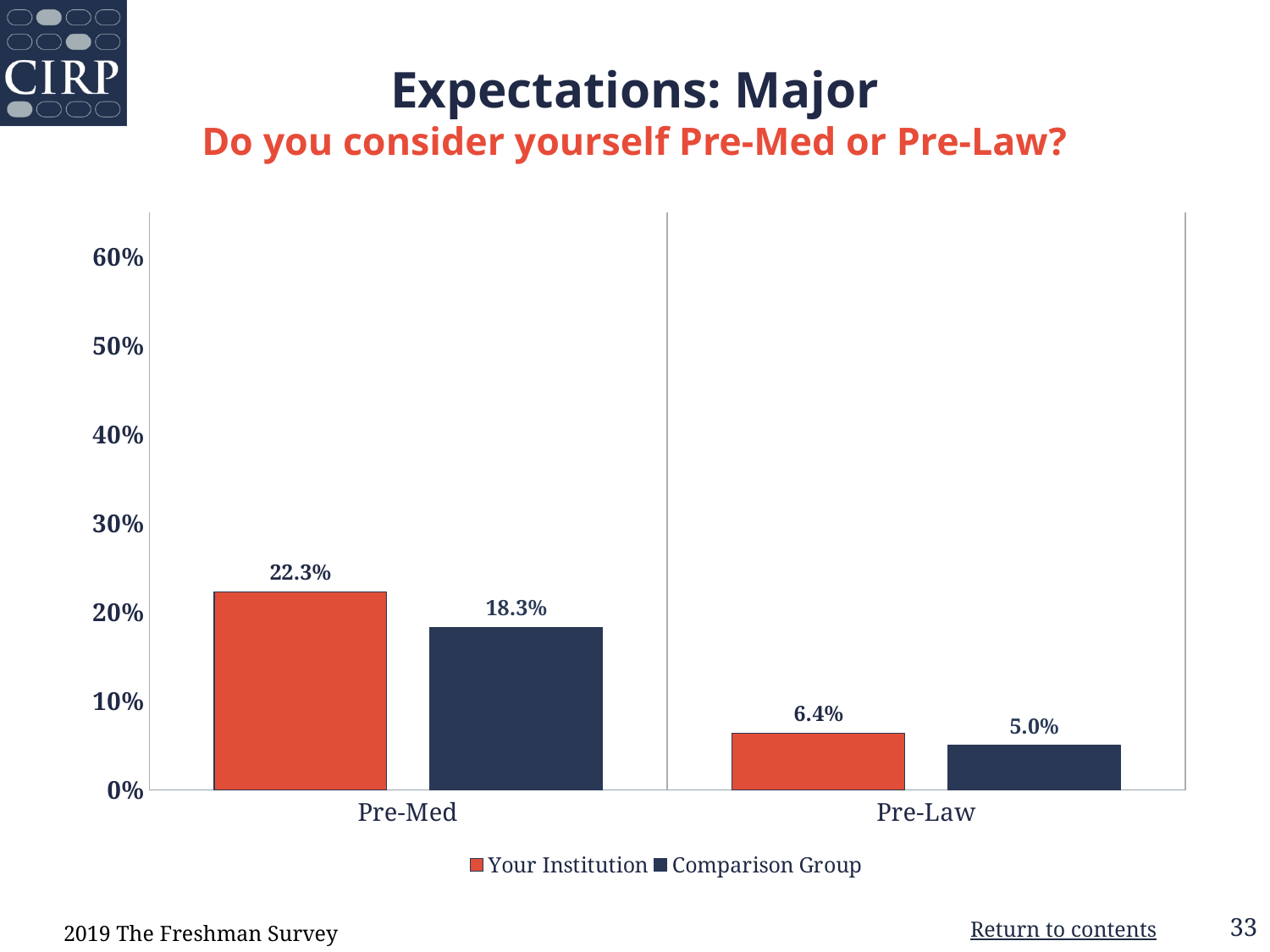
What is the difference between Your Institution and Comparison Group in the Pre-Law category? 1.4% What kind of chart is shown on the slide? bar chart What is the value for Comparison Group in the Pre-Law category? 5.0% Which category has the lowest value for Your Institution? Pre-Law Which is larger in the Pre-Med category: Your Institution or Comparison Group? Your Institution What is the value for Your Institution in the Pre-Med category? 22.3% How many series does the legend list? 2 Which category has the highest value for Comparison Group? Pre-Med Is the value for Comparison Group in the Pre-Med category greater or less than 20%? less What is the difference between Your Institution and Comparison Group in the Pre-Med category? 4.0% What is the value for Your Institution in the Pre-Law category? 6.4% How many categories are shown on the x axis? 2